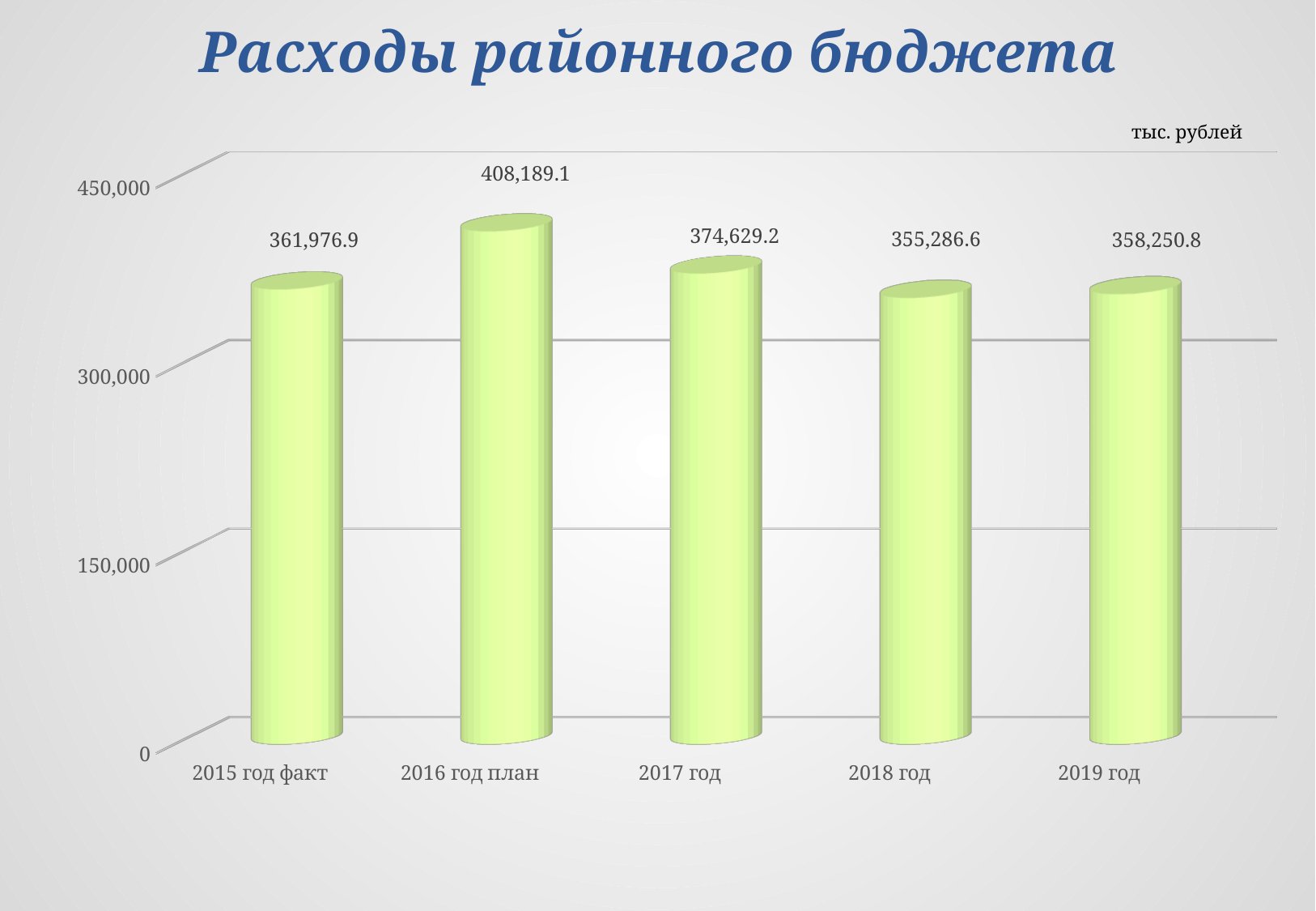
Which category has the lowest value? 2018 год Which category has the highest value? 2016 год план How many categories are shown on the x axis? 5 What is the value for 2018 год? 355,286.6 What kind of chart is shown on the slide? bar chart What is the value for 2016 год план? 408,189.1 What is the value for 2015 год факт? 361,976.9 Is the value for 2017 год greater or less than 300,000? greater What is the difference between the values for 2017 год and 2018 год? 19,342.6 Which is larger, the value for 2019 год or the value for 2018 год? 2019 год What unit is stated above the chart? тыс. рублей What is the difference between the values for 2016 год план and 2015 год факт? 46,212.2